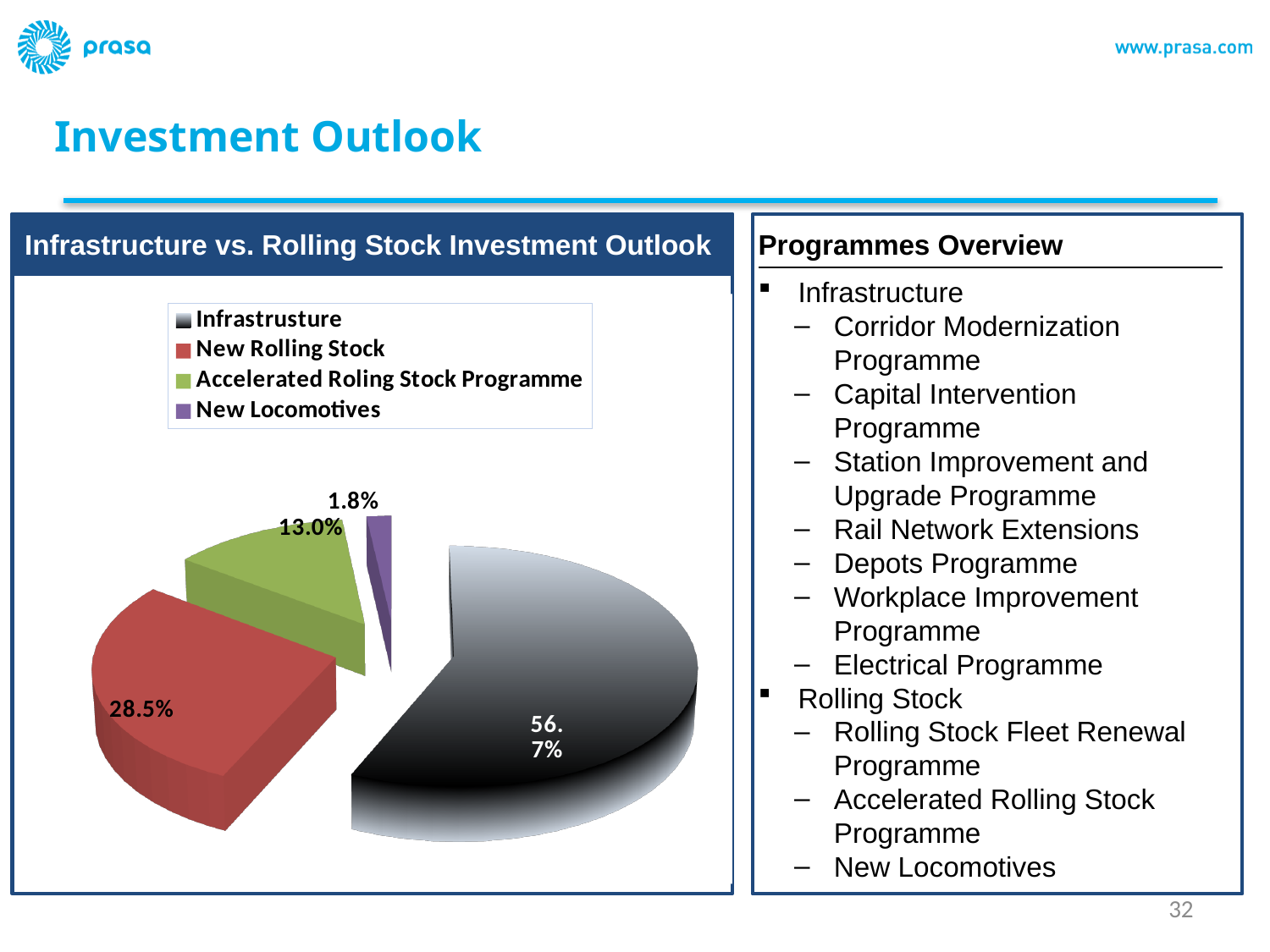
Which is larger, the share for New Rolling Stock or the share for the Accelerated Rolling Stock Programme? New Rolling Stock What type of chart is shown on the slide? Pie chart Which category has the smallest share of the pie? New Locomotives What is the title of the chart? Infrastructure vs. Rolling Stock Investment Outlook What share of the pie does New Rolling Stock represent? 28.5% What share of the pie does New Locomotives represent? 1.8% What share of the pie does Infrastructure represent? 56.7% What share of the pie does the Accelerated Rolling Stock Programme represent? 13.0% Which category has the largest share of the pie? Infrastrusture What is the difference in percentage points between Infrastructure and New Rolling Stock? 28.2 percentage points How many slices does the pie chart have? 4 What colour is the New Locomotives slice in the pie chart? Purple